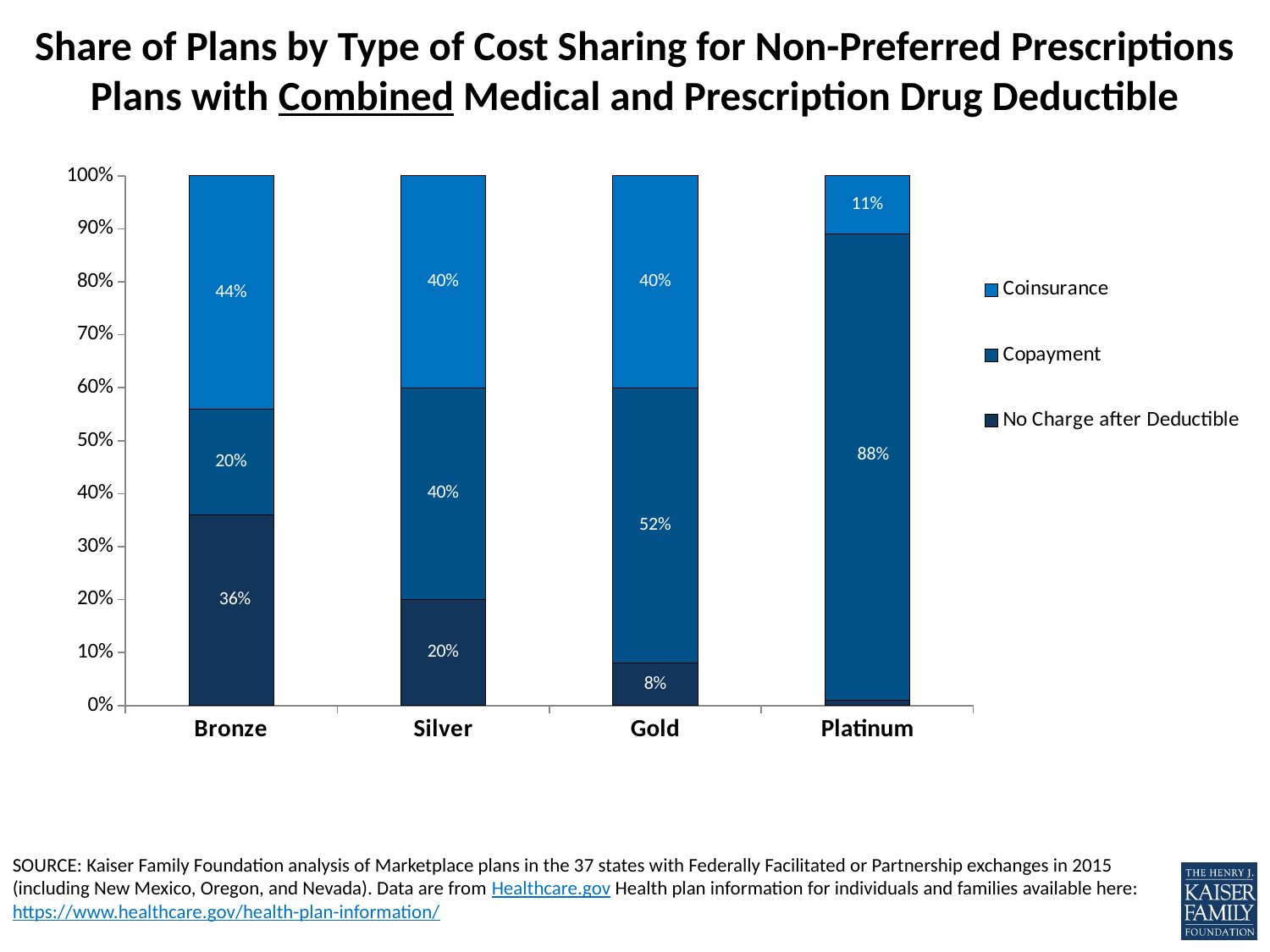
What is the Copayment value for Gold plans? 52% What is the difference between the Copayment share for Gold and the Copayment share for Bronze? 32 percentage points What is the Copayment share for Platinum plans? 88% How many series does the legend list? 3 What kind of chart is shown on the slide? Stacked bar chart What share of Bronze plans have coinsurance for non-preferred prescriptions? 44% Is the No Charge after Deductible share larger for Bronze or for Gold? Bronze How many metal levels are shown on the x axis? 4 Which metal level has the highest Copayment share? Platinum What is the No Charge after Deductible value for Silver plans? 20% Which metal level has the lowest Coinsurance share? Platinum Which legend entry is shown in the lightest blue? Coinsurance